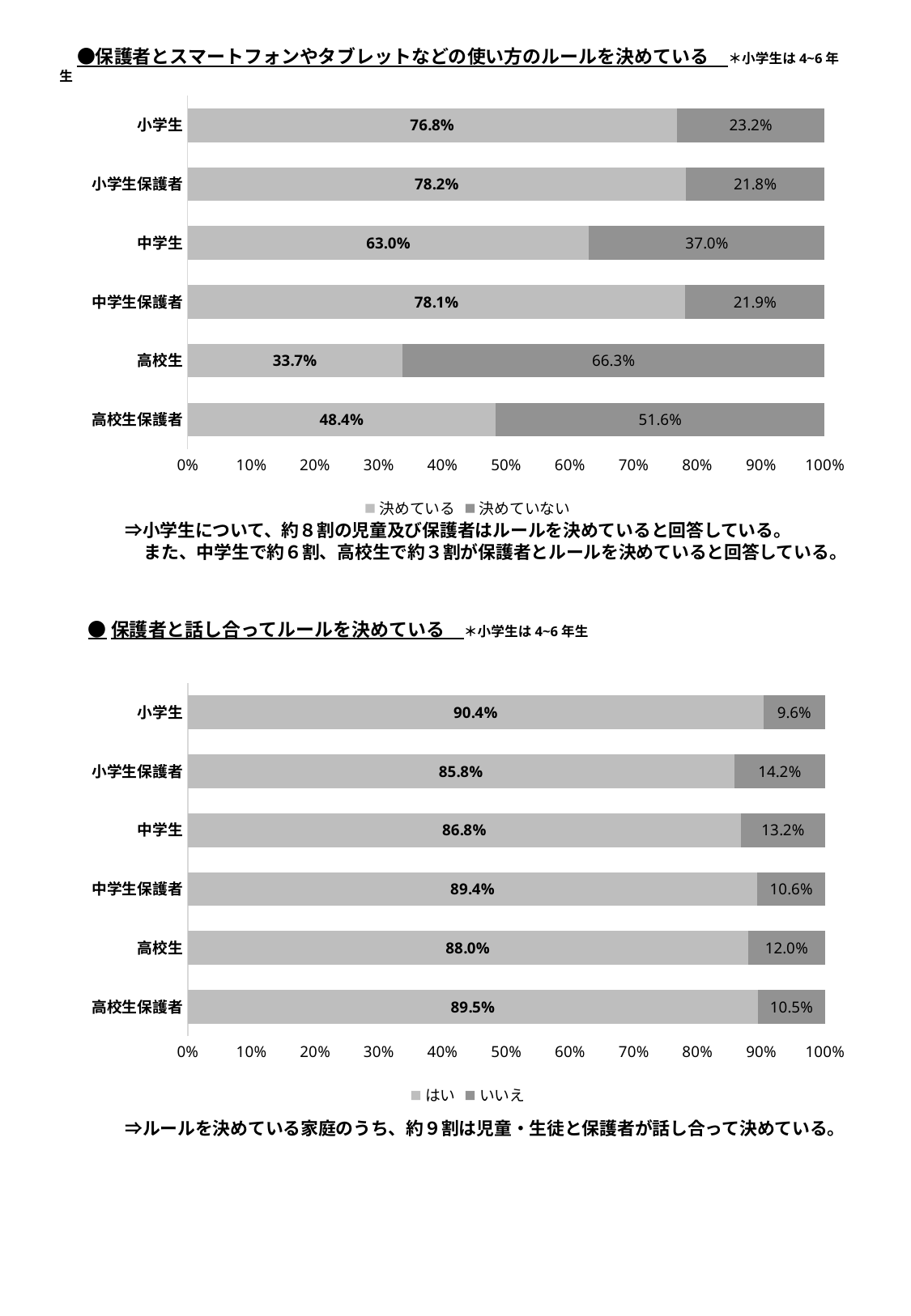
In the bottom chart, what is the いいえ value for 小学生保護者? 14.2% In the top chart, which category has the highest 決めている value? 小学生保護者 In the top chart (保護者とスマートフォンやタブレットなどの使い方のルールを決めている), what is the 決めている value for 中学生? 63.0% In the top chart, what is the 決めていない value for 高校生? 66.3% In the top chart, what is the difference between the 決めている values for 小学生保護者 and 高校生保護者? 29.8% In the bottom chart, which category has the highest はい value? 小学生 What kind of chart is the bottom chart? Stacked bar chart In the top chart, which category has the lowest 決めている value? 高校生 In the top chart, which is larger: the 決めている value for 中学生 or for 高校生保護者? 中学生 In the top chart, how many categories are shown on the vertical axis? 6 In the bottom chart, how many series does the legend list? 2 In the bottom chart (保護者と話し合ってルールを決めている), what is the はい value for 小学生? 90.4%